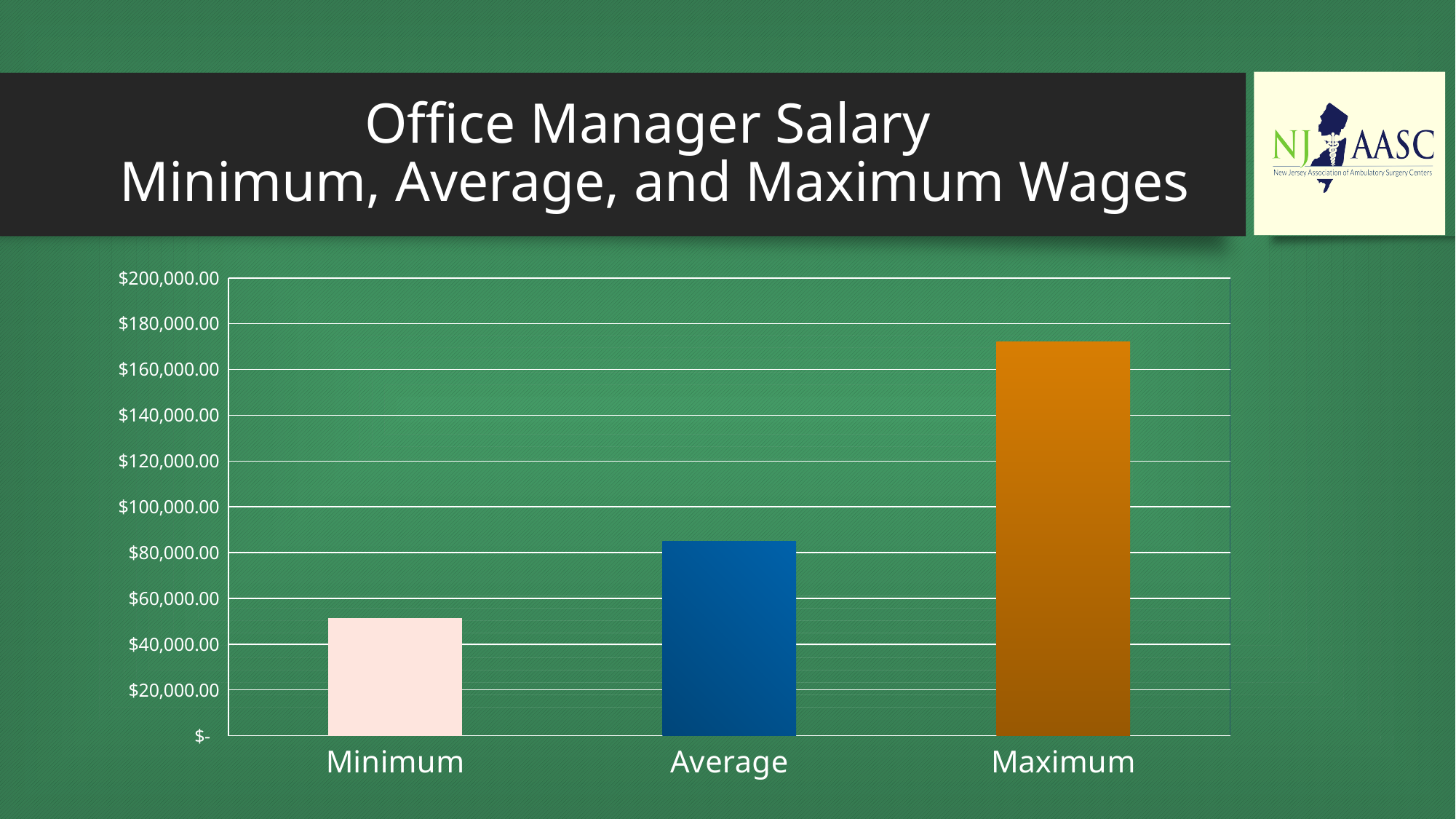
Which is larger, the value for Average or the value for Minimum? Average Is the value for Maximum greater or less than $160,000.00? greater Is the value for Minimum greater or less than $60,000.00? less What colour is the bar for Average? blue Is the value for Maximum greater or less than $180,000.00? less Do the values rise or fall moving from Minimum to Maximum along the x axis? rise Which category has the highest value? Maximum How many categories are plotted on the chart? 3 What kind of chart is shown on the slide? bar chart What is the title of the slide containing the chart? Office Manager Salary Minimum, Average, and Maximum Wages Which category has the lowest value? Minimum